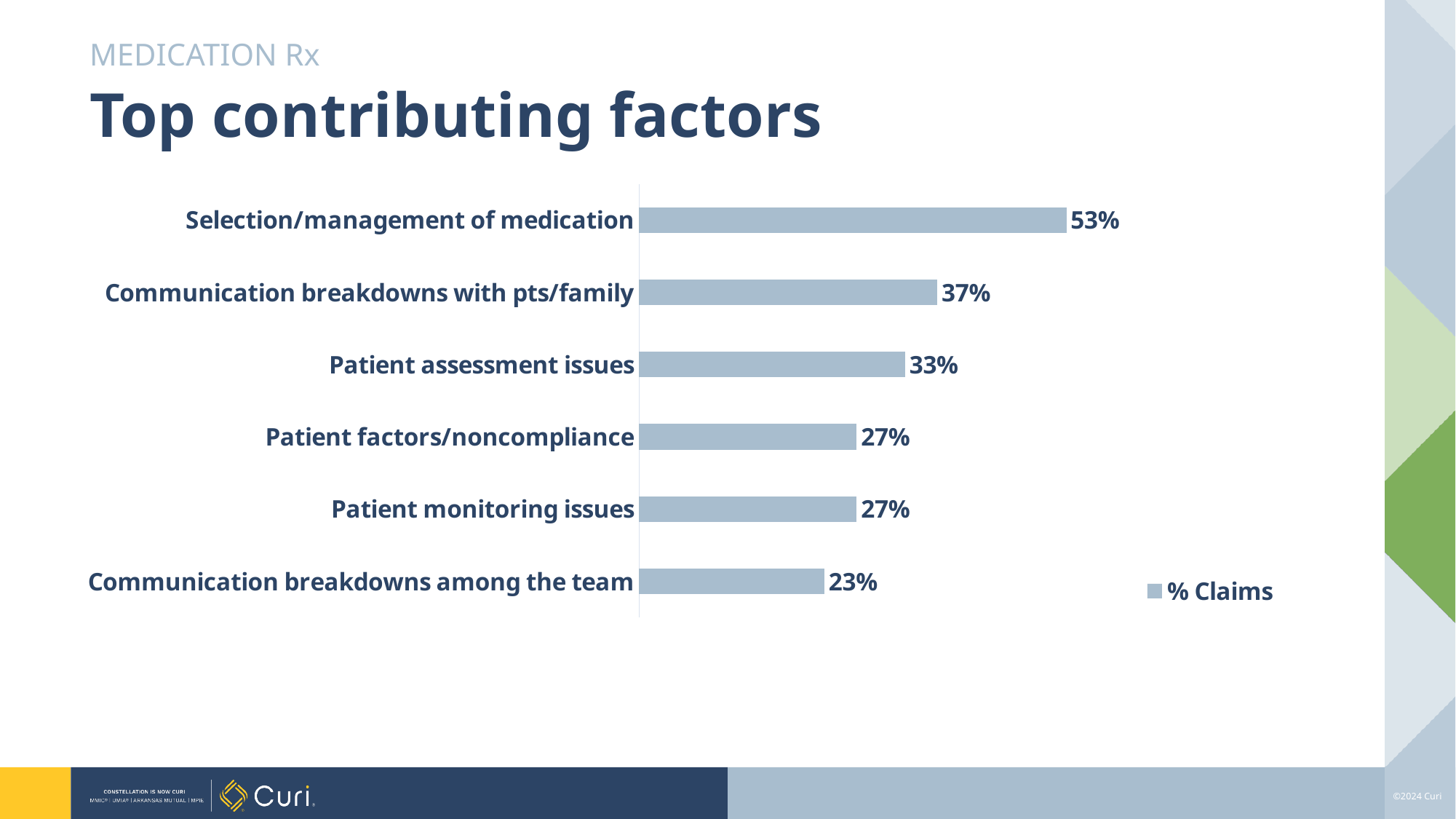
Which contributing factor has the lowest % Claims? Communication breakdowns among the team What is the % Claims value for Communication breakdowns among the team? 23% What is the legend entry shown on the chart? % Claims How many series does the legend list? 1 Which contributing factor has the highest % Claims? Selection/management of medication How many contributing factors are shown in the chart? 6 Which has a higher % Claims: Patient assessment issues or Patient factors/noncompliance? Patient assessment issues What kind of chart is shown on the slide? Bar chart What is the % Claims value for Communication breakdowns with pts/family? 37% What is the % Claims value for Selection/management of medication? 53% What is the difference in % Claims between Selection/management of medication and Communication breakdowns with pts/family? 16% What is the % Claims value for Patient assessment issues? 33%